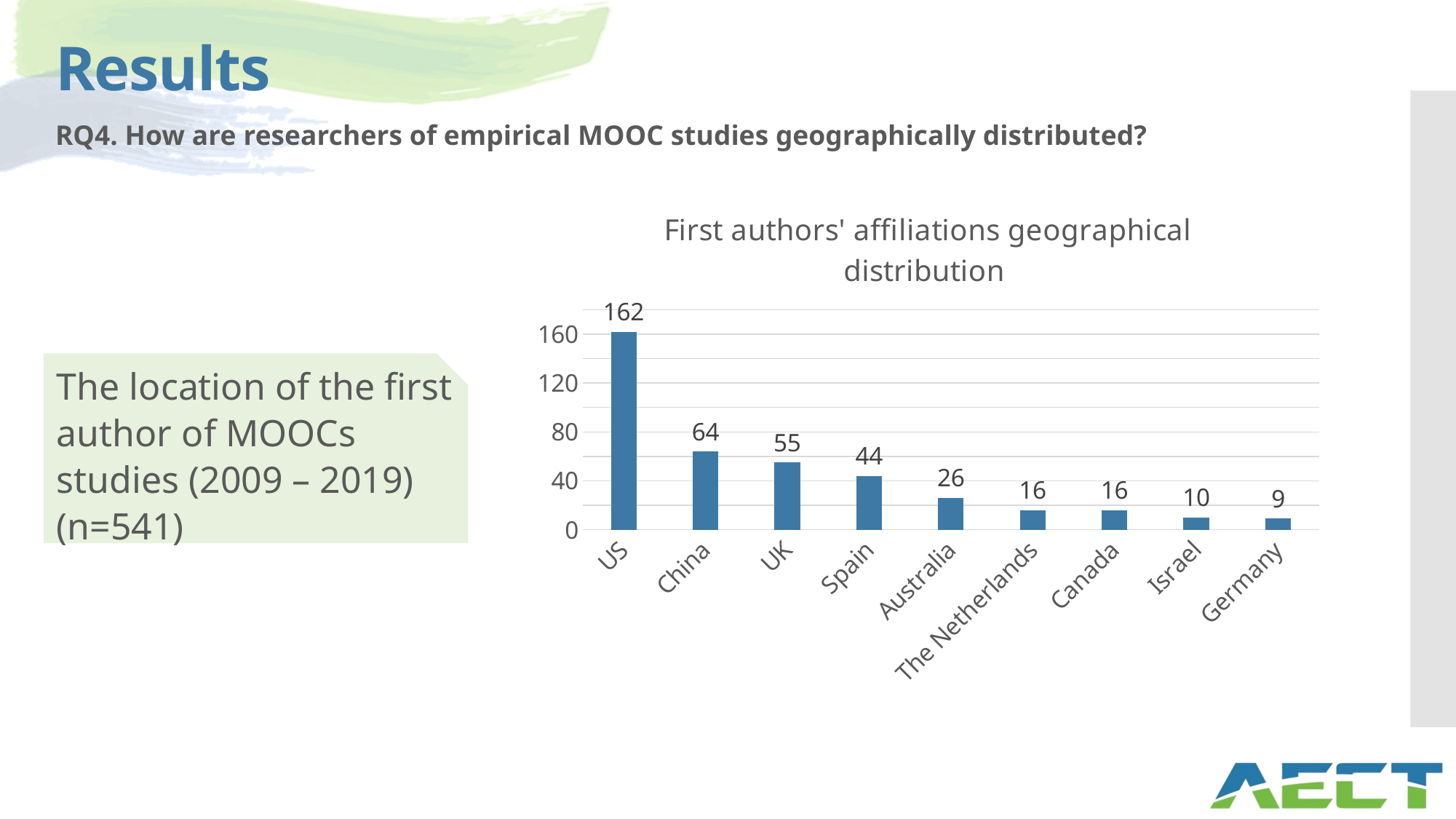
What is the value for The Netherlands? 16 Which country has the lowest value? Germany What is the difference between the values for the US and Australia? 136 What is the difference between the values for China and the UK? 9 Which has a larger value, Israel or Australia? Australia What kind of chart is shown on the slide? bar chart Is the value for China greater or less than 80? less What is the value for Spain? 44 How many countries are shown on the x axis? 9 Which country has the highest value? US What is the title of the chart? First authors' affiliations geographical distribution What is the value for the US? 162